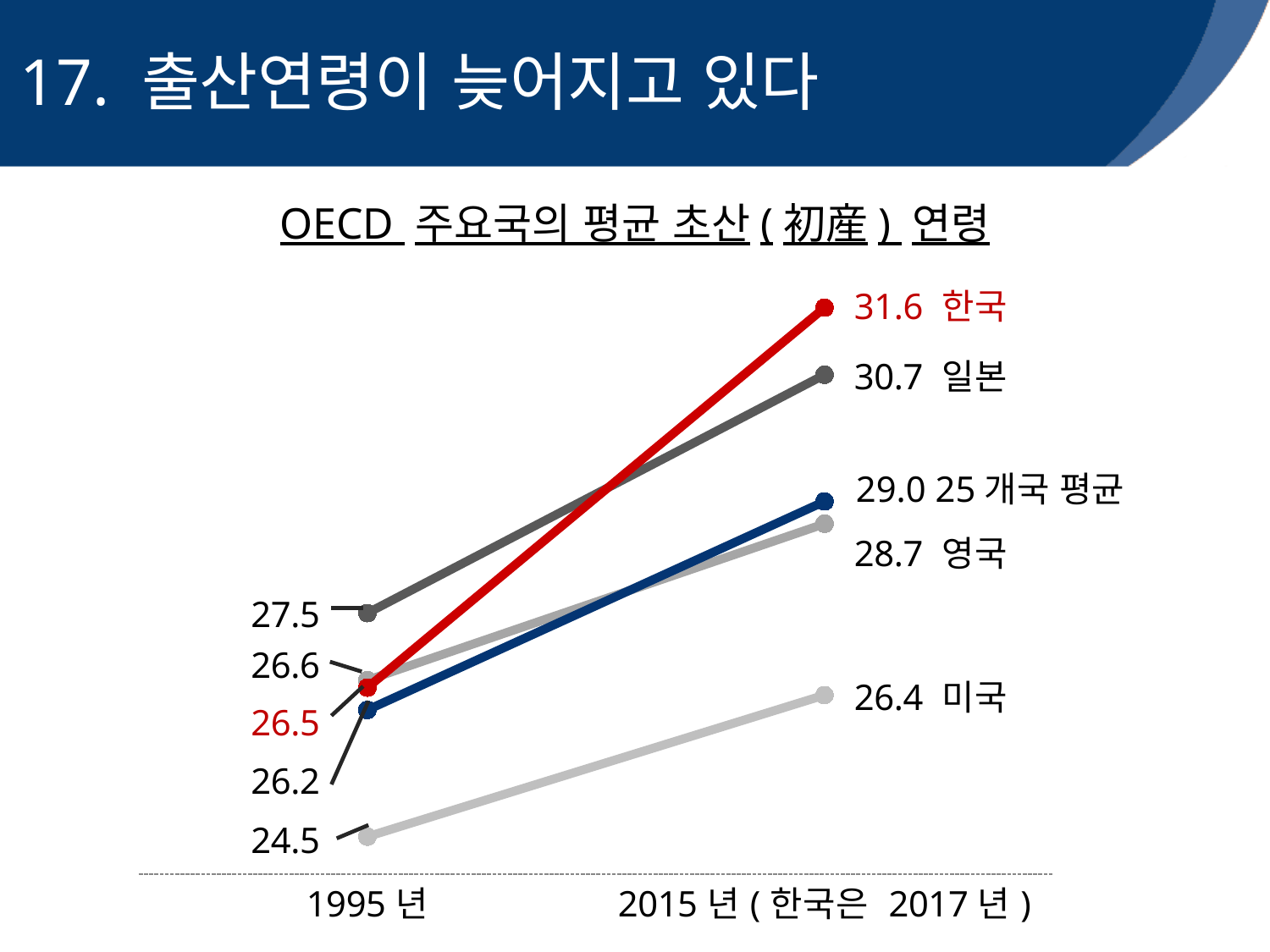
What is the value for 일본 at 2015년? 30.7 What kind of chart is shown on the slide? line chart What is the value for 한국 at 1995년? 26.5 What is the chart's title? OECD 주요국의 평균 초산(初産) 연령 How many lines (countries or groups) are plotted on the chart? 5 Do the values rise or fall from 1995년 to 2015년? rise What is the difference between the 한국 value at 2015년 (2017년) and at 1995년? 5.1 Which country or group has the highest value at 2015년? 한국 Which country has the lowest value at 1995년? 미국 What is the value for 한국 at 2015년 (한국은 2017년)? 31.6 Which is larger at 2015년, the value for 25개국 평균 or the value for 영국? 25개국 평균 What is the value for 미국 at 2015년? 26.4